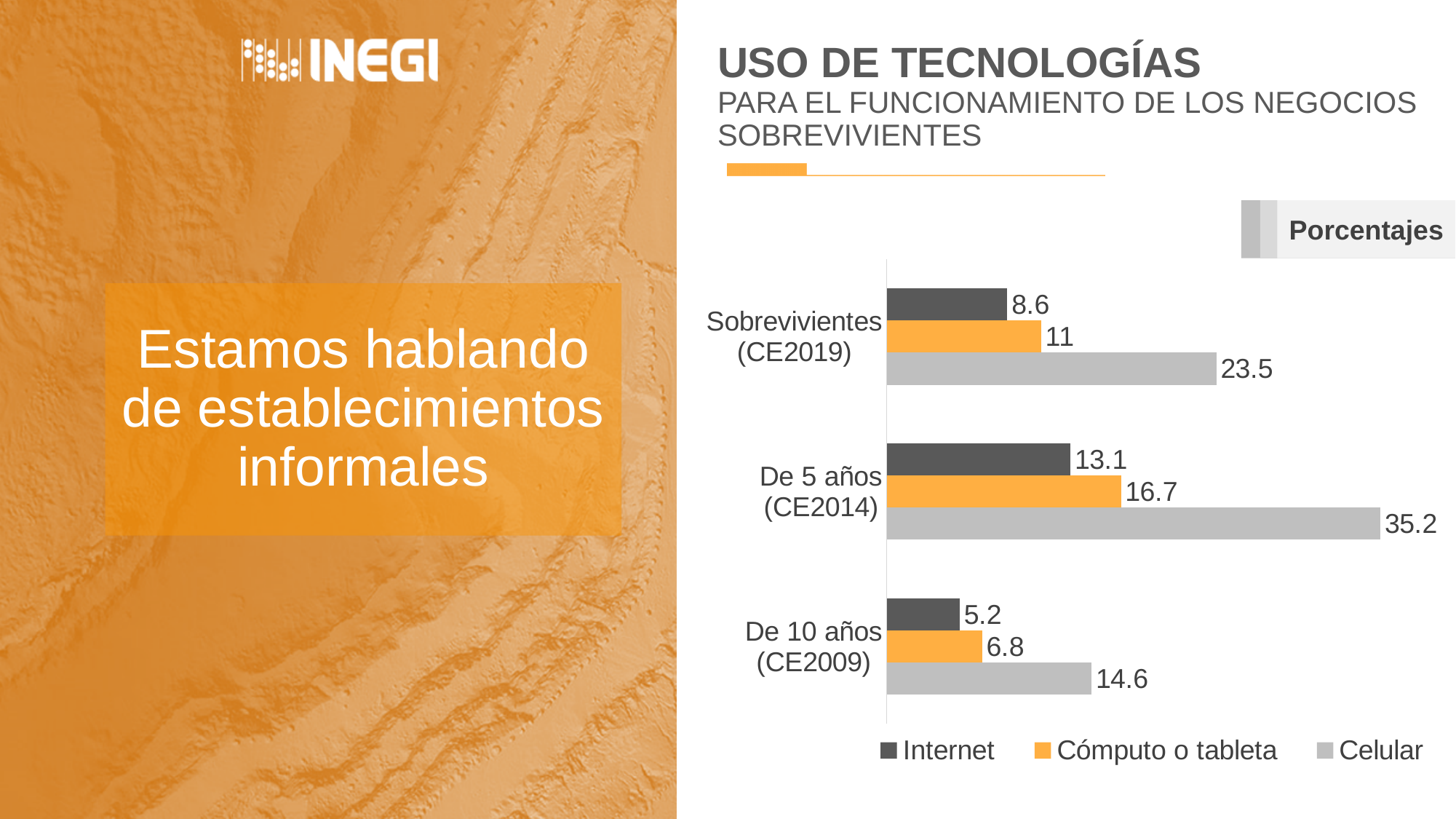
Which series is shown in orange in the legend? Cómputo o tableta What is the difference between the Cómputo o tableta and Internet values for De 5 años (CE2014)? 3.6 Which category has the highest Celular value? De 5 años (CE2014) What is the Celular value for De 5 años (CE2014)? 35.2 What kind of chart is shown on the slide? Bar chart How many series does the legend list? 3 Which category has the lowest Internet value? De 10 años (CE2009) How many categories are shown on the chart? 3 What is the difference between the Celular values for De 5 años (CE2014) and Sobrevivientes (CE2019)? 11.7 Which is larger for Sobrevivientes (CE2019): the Internet value or the Cómputo o tableta value? Cómputo o tableta What is the Internet value for Sobrevivientes (CE2019)? 8.6 What is the Cómputo o tableta value for De 10 años (CE2009)? 6.8